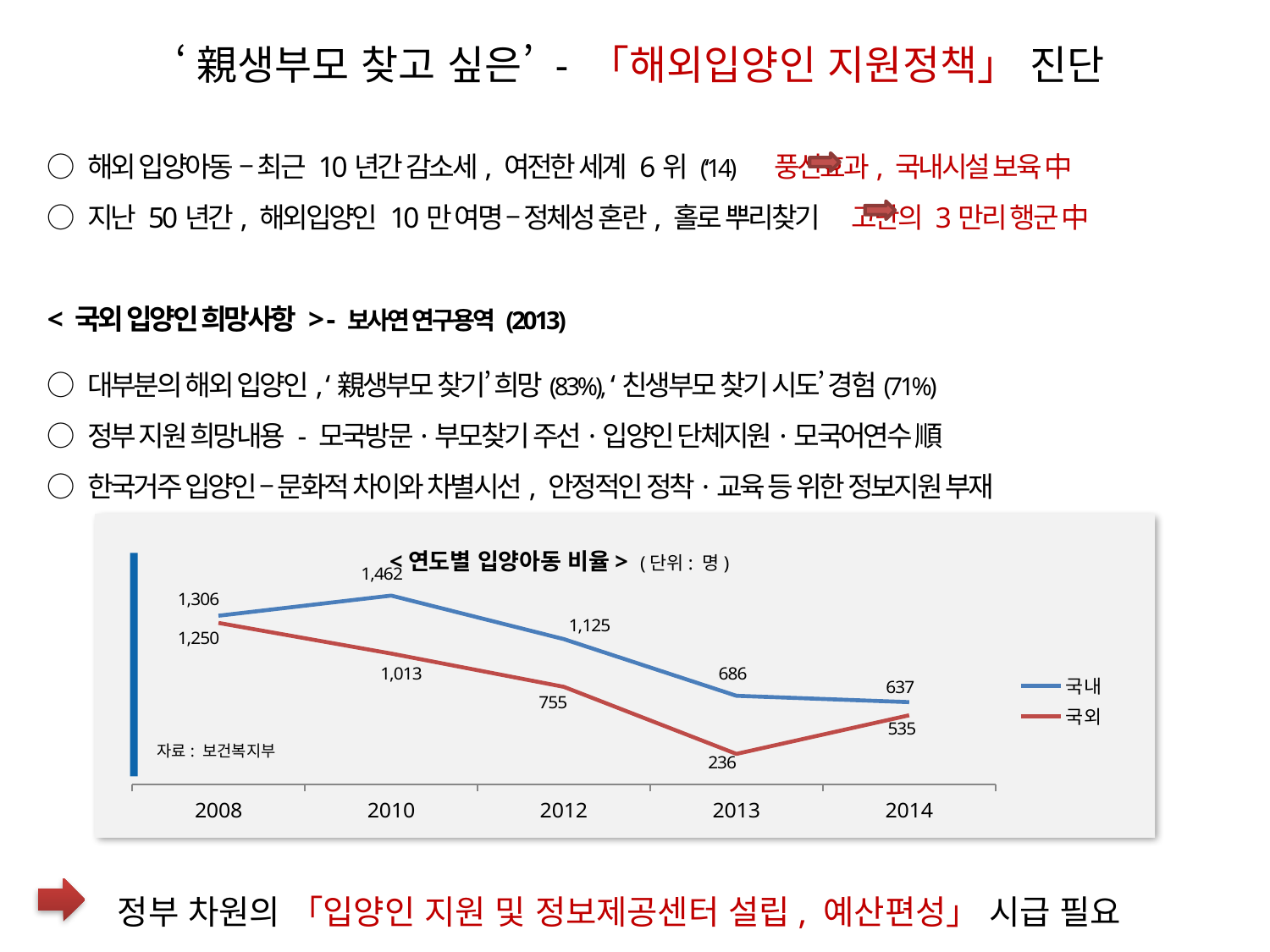
How many series does the chart legend list? 2 What kind of chart is shown on the slide? line chart How many years are plotted along the x axis of the chart? 5 In which year is the 국내 series highest? 2010 What is the value for 국외 in 2013? 236 Which colour is used for the 국외 series in the chart? red In which year is the 국외 series lowest? 2013 What is the value for 국내 in 2010? 1,462 What is the value for 국외 in 2014? 535 Which is larger in 2008, 국내 or 국외? 국내 Does the 국내 series rise or fall from 2010 to 2014? fall What is the difference between 국내 and 국외 in 2012? 370